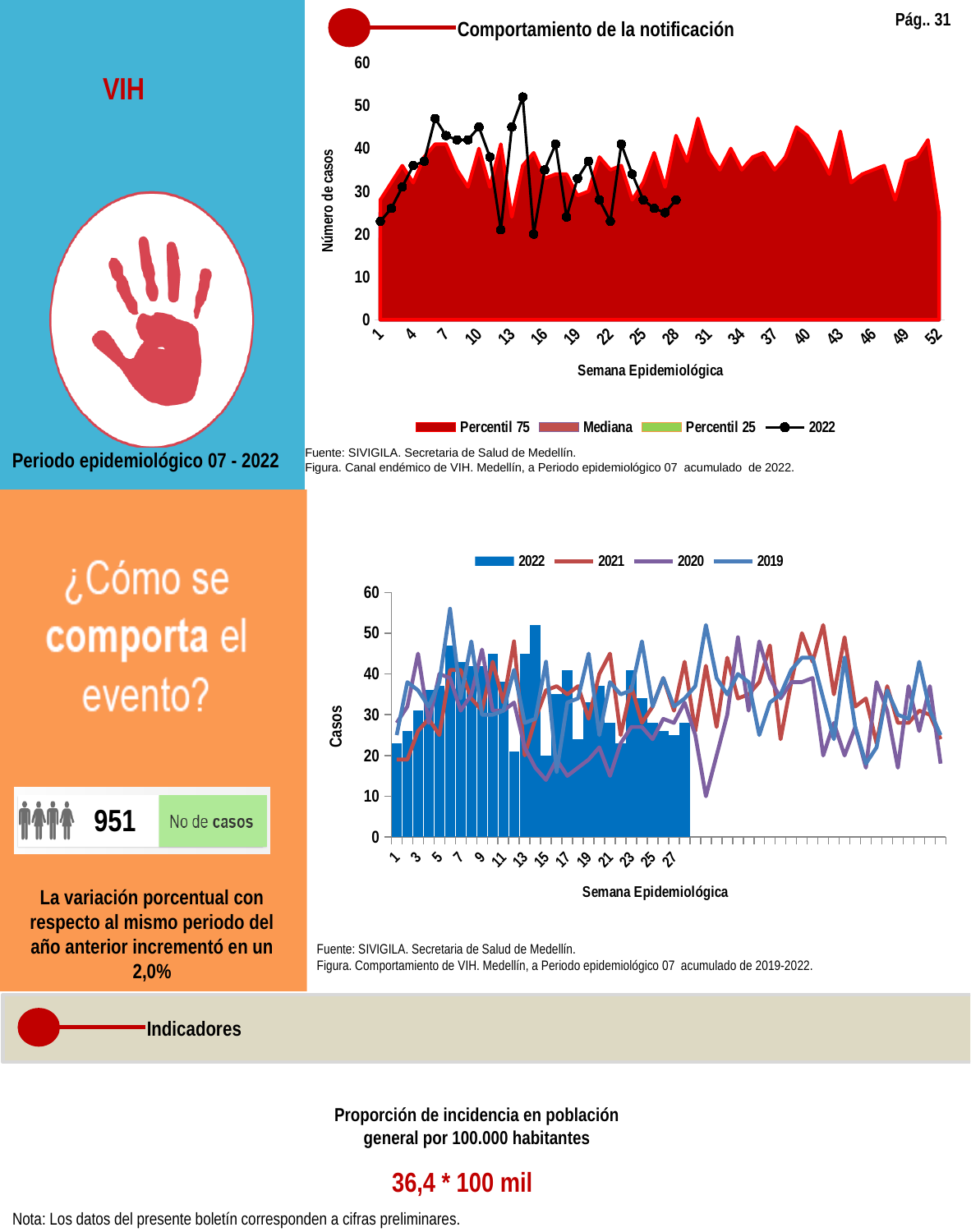
In the top chart 'Comportamiento de la notificación', at which epidemiological week does the 2022 line reach its highest value? 14 In the bottom chart, is the 2022 bar at week 13 greater or less than 30? greater In the top chart 'Comportamiento de la notificación', which is larger for the 2022 series: the value at week 14 or the value at week 15? week 14 In the top chart 'Comportamiento de la notificación', is the 2022 value at week 14 greater or less than 40? greater In the bottom chart, at which epidemiological week is the 2022 bar the tallest? 14 In the top chart 'Comportamiento de la notificación', what is the title of the y axis? Número de casos In the bottom chart, what is the title of the x axis? Semana Epidemiológica In the bottom chart, how many series does the legend list? 4 In the top chart 'Comportamiento de la notificación', how many series does the legend list? 4 In the top chart 'Comportamiento de la notificación', is the 2022 value at week 1 greater or less than 30? less In the bottom chart, what kind of chart is used for the 2022 series? bar chart In the bottom chart, how many bars are plotted for the 2022 series? 28